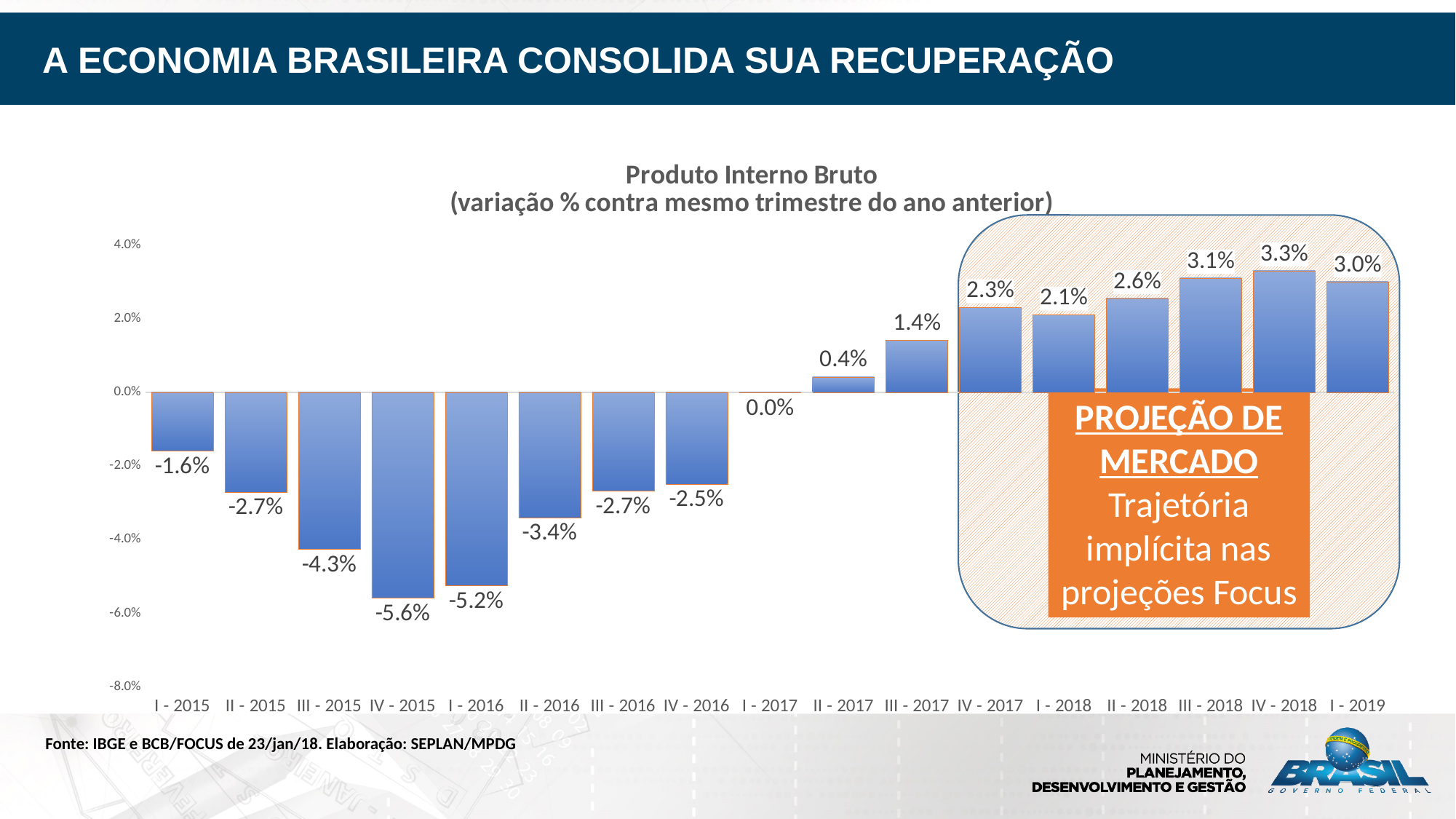
Do the values rise or fall from I - 2017 to IV - 2017? rise What is the title of the chart? Produto Interno Bruto (variação % contra mesmo trimestre do ano anterior) What kind of chart is shown on the slide? bar chart What is the value for I - 2019? 3.0% What is the value for III - 2017? 1.4% What is the difference between the values for IV - 2018 and I - 2018? 1.2% How many quarters are shown on the x axis? 17 Which quarter has the highest value? IV - 2018 Which is larger, the value for III - 2015 or the value for I - 2016? III - 2015 Is the value for II - 2016 greater or less than -4.0%? greater What is the value for IV - 2015? -5.6% Which quarter has the lowest value? IV - 2015